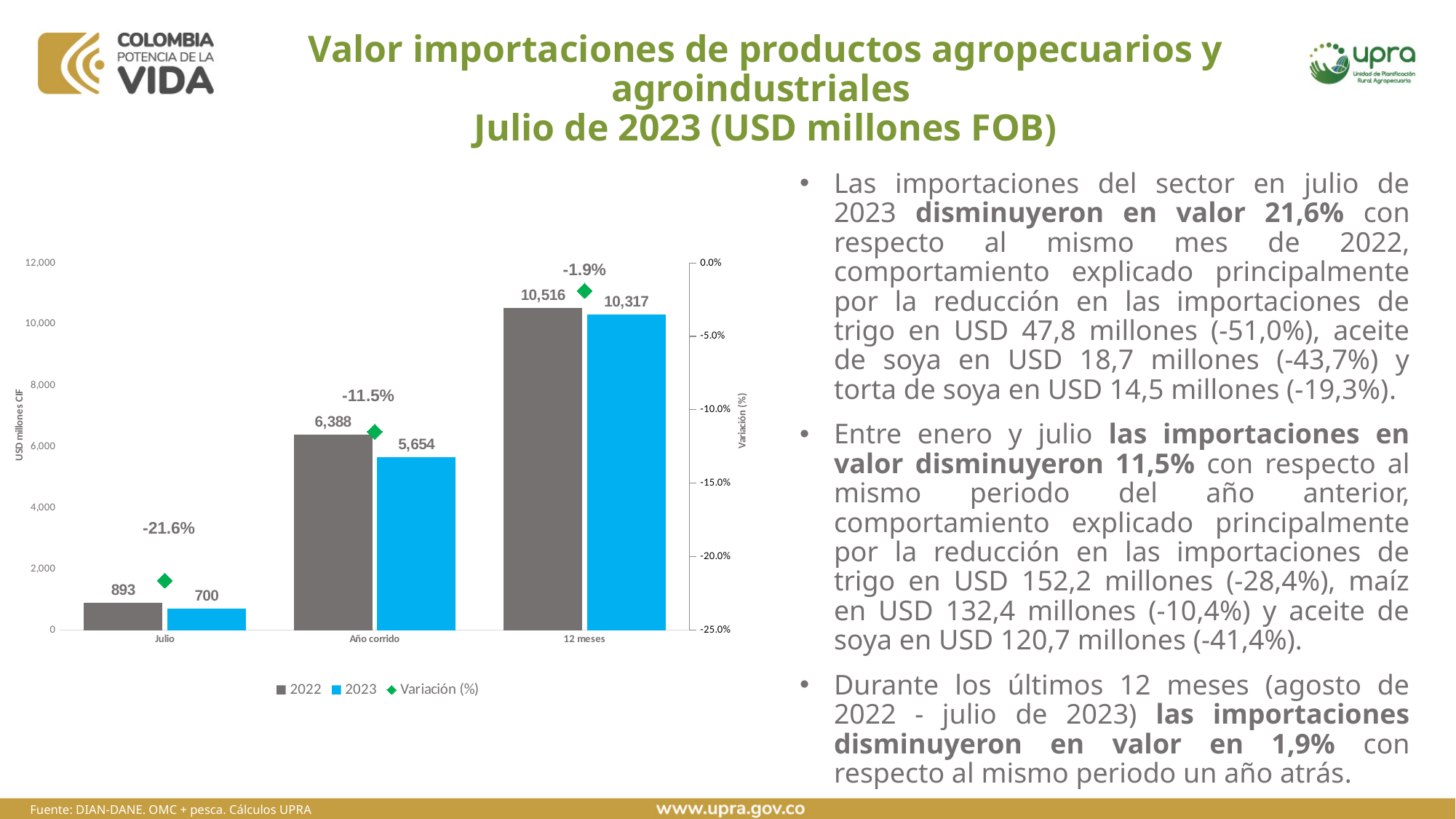
What is the difference between the 2022 and 2023 values in the Año corrido category? 734 Which category has the lowest value for the 2023 series? Julio What colour are the bars for the 2023 series? Blue What kind of chart is shown on the slide? Bar chart with markers for Variación (%) How many series does the chart legend list? 3 What is the Variación (%) shown for the 12 meses category? -1.9% What is the value for 2023 in the 12 meses category? 10,317 What is the value for 2023 in the Año corrido category? 5,654 What is the value for 2022 in the Julio category? 893 In the Julio category, which is larger, the 2022 value or the 2023 value? 2022 Which category has the highest value for the 2022 series? 12 meses How many categories are shown on the x axis of the chart? 3